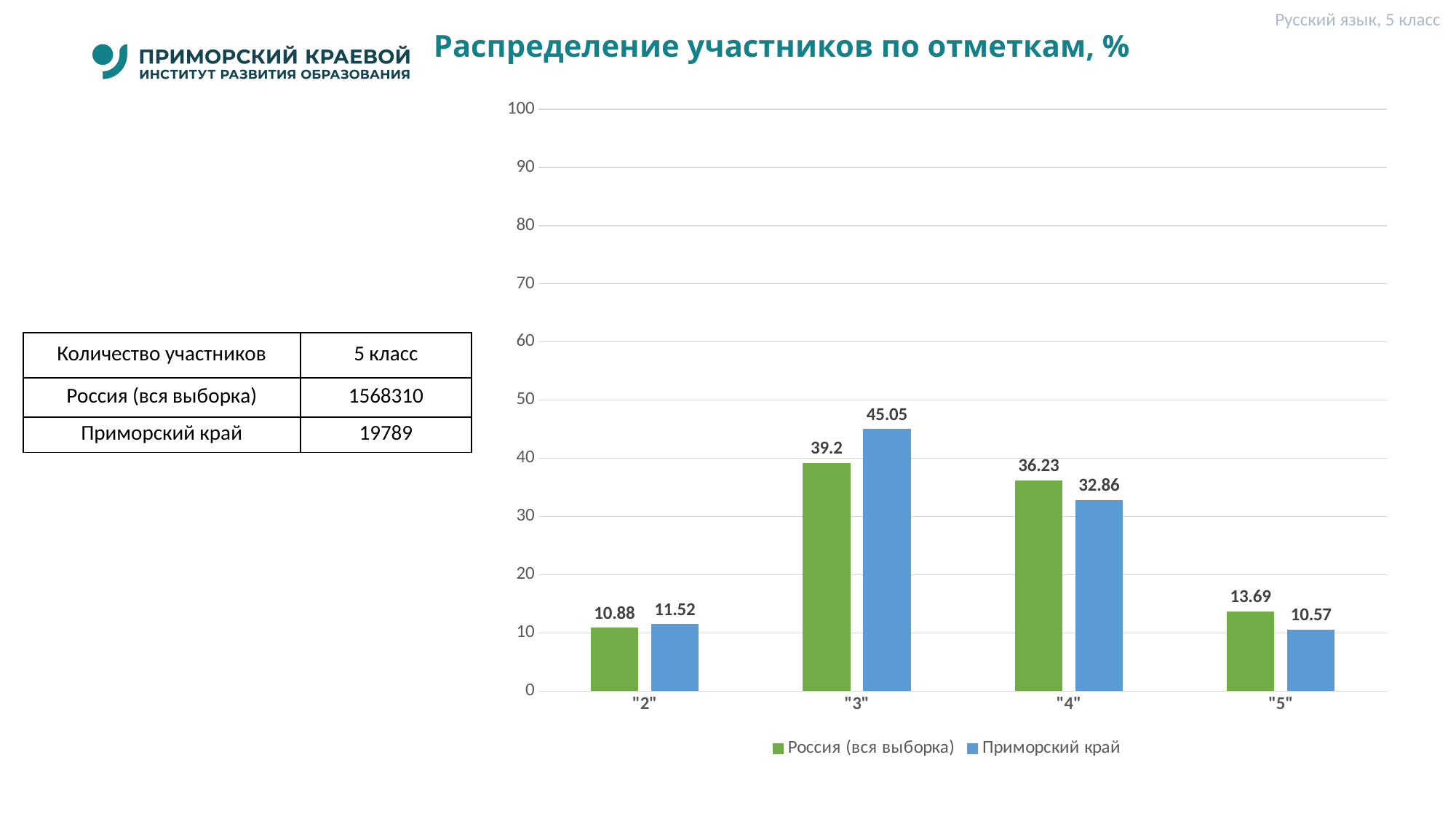
Which mark has the lowest value for Россия (вся выборка)? "2" What is the difference between Приморский край and Россия (вся выборка) at mark "3"? 5.85 Is the value for Приморский край at mark "3" greater or less than 40? greater What is the value for Приморский край at mark "4"? 32.86 What is the value for Приморский край at mark "2"? 11.52 What kind of chart is shown on the slide? bar chart How many mark categories are shown on the x axis? 4 At mark "5", which series has the larger value: Россия (вся выборка) or Приморский край? Россия (вся выборка) How many series does the legend list? 2 What is the title of the chart? Распределение участников по отметкам, % What is the value for Россия (вся выборка) at mark "3"? 39.2 Which mark has the highest value for Приморский край? "3"